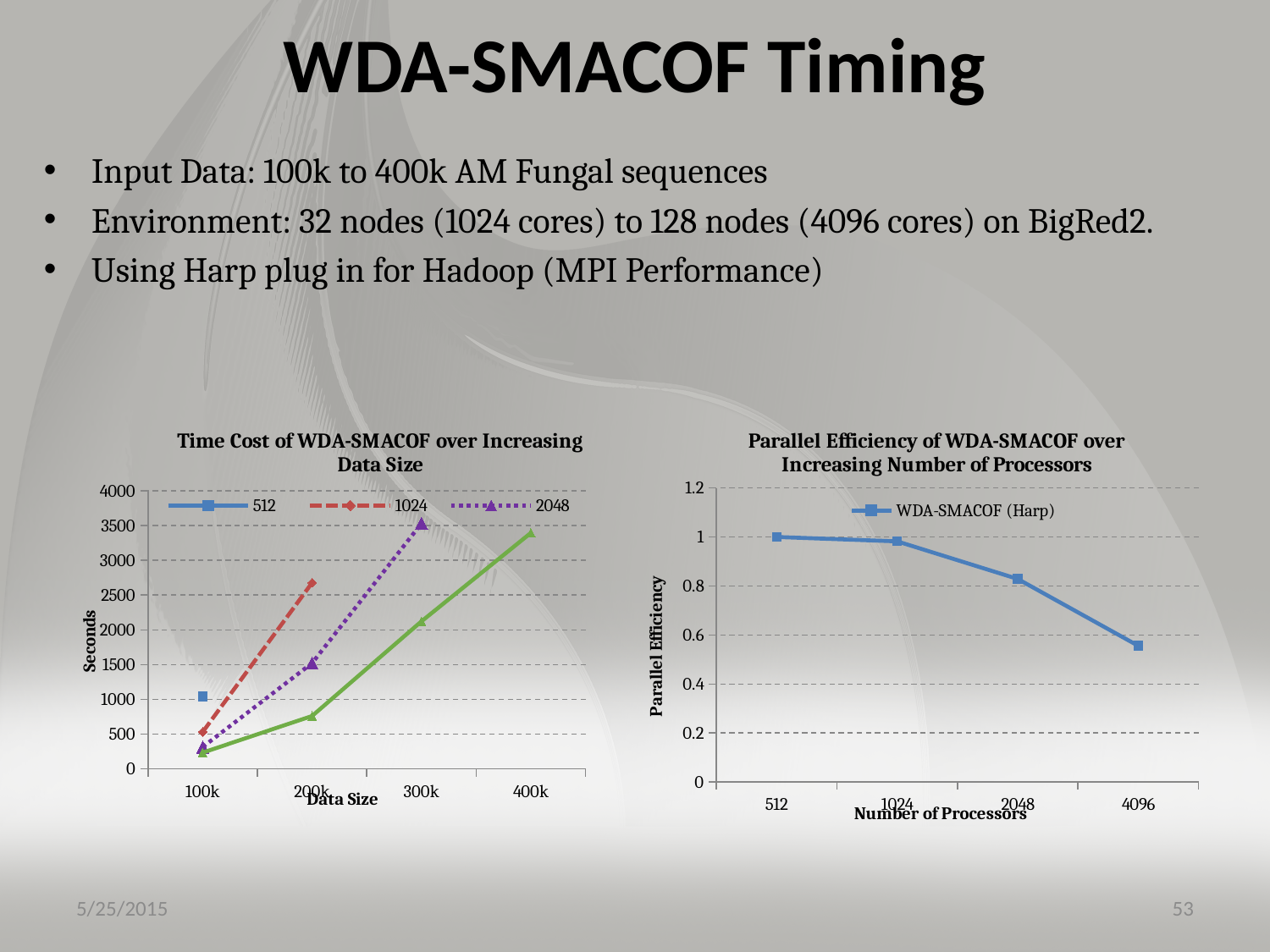
In the 'Time Cost of WDA-SMACOF over Increasing Data Size' chart, is the value of the 512 series at 100k greater or less than 1500? less In the 'Time Cost of WDA-SMACOF over Increasing Data Size' chart, is the value of the 1024 series at 200k greater or less than 2500? greater In the 'Parallel Efficiency of WDA-SMACOF over Increasing Number of Processors' chart, what is the parallel efficiency at 512 processors? 1 In the 'Time Cost of WDA-SMACOF over Increasing Data Size' chart, is the value of the 2048 series at 300k greater or less than 3000? greater What kind of chart is the 'Parallel Efficiency of WDA-SMACOF over Increasing Number of Processors' chart? line chart What kind of chart is the 'Time Cost of WDA-SMACOF over Increasing Data Size' chart? line chart In the 'Parallel Efficiency of WDA-SMACOF over Increasing Number of Processors' chart, which number of processors has the lowest parallel efficiency? 4096 How many series does the legend of the 'Time Cost of WDA-SMACOF over Increasing Data Size' chart list? 3 In the 'Time Cost of WDA-SMACOF over Increasing Data Size' chart, at 100k, which series has the larger value: 512 or 1024? 512 In the 'Parallel Efficiency of WDA-SMACOF over Increasing Number of Processors' chart, does the parallel efficiency rise or fall as the number of processors increases? fall How many data size categories are shown on the x axis of the 'Time Cost of WDA-SMACOF over Increasing Data Size' chart? 4